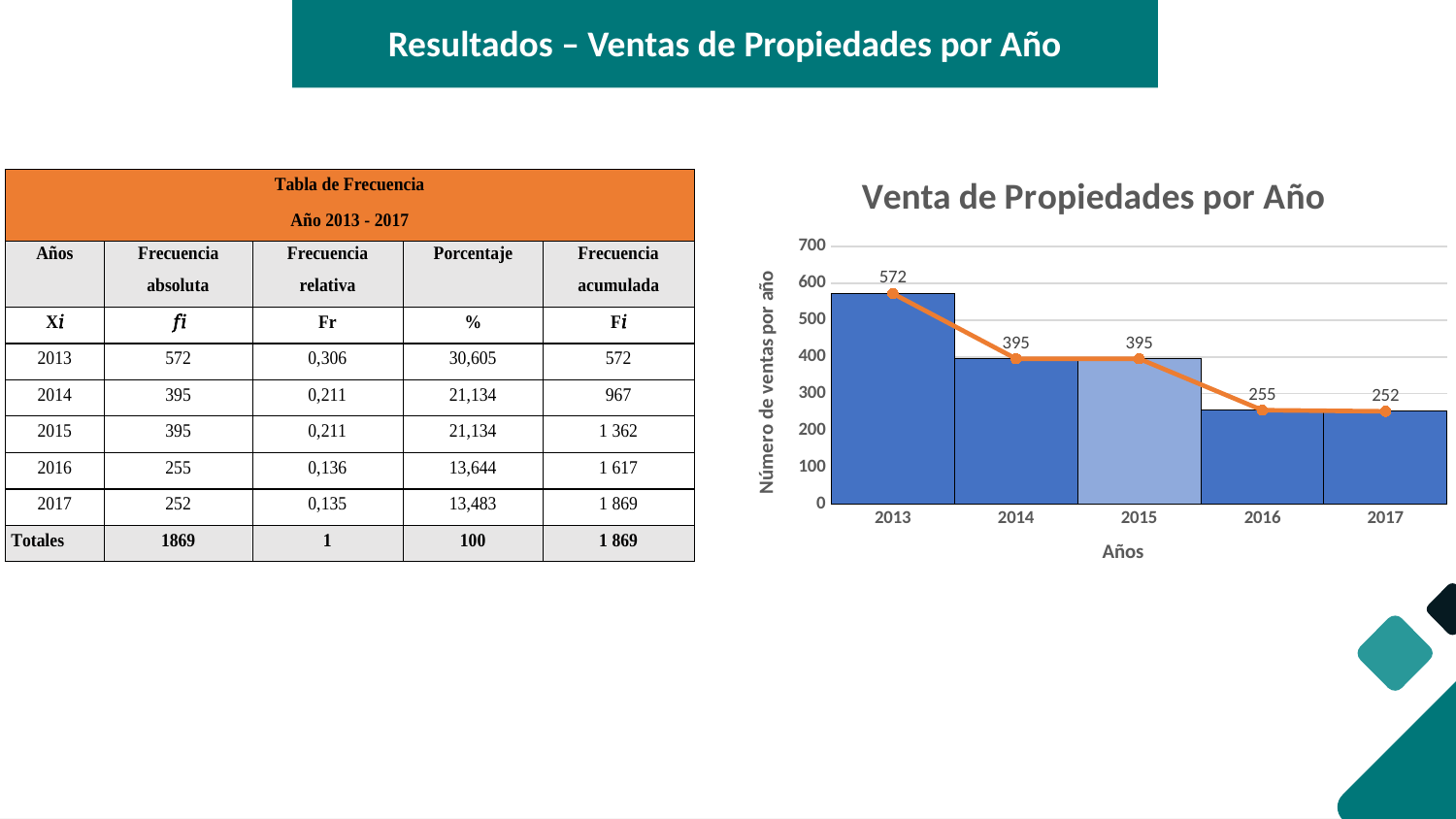
Do the values rise or fall from 2013 to 2017? fall Is the value for 2017 greater or less than 300? less What is the difference between the values for 2016 and 2017? 3 What is the value for 2013 in the chart? 572 What is the title of the chart? Venta de Propiedades por Año What is the value for 2017 in the chart? 252 Is the value for 2013 greater or less than 500? greater Which year has the highest value in the chart? 2013 What is the difference between the values for 2013 and 2014? 177 How many years are shown on the x axis of the chart? 5 What is the value for 2016 in the chart? 255 Which is larger, the value for 2014 or the value for 2016? 2014